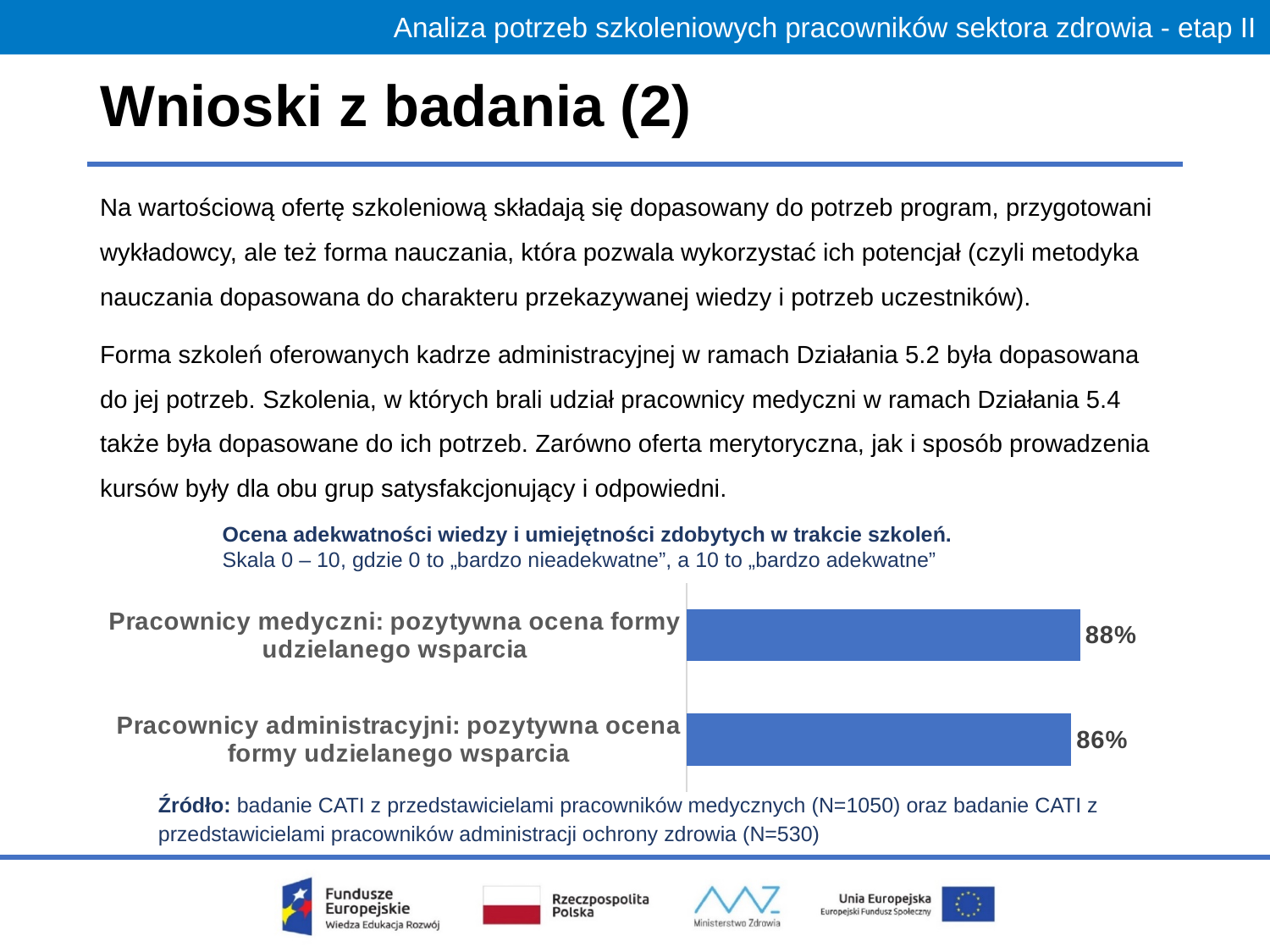
What colour are the bars in the chart? blue What kind of chart is shown on the slide? bar chart Which category has the higher value? Pracownicy medyczni: pozytywna ocena formy udzielanego wsparcia How many categories are shown in the chart? 2 What is the value for "Pracownicy administracyjni: pozytywna ocena formy udzielanego wsparcia"? 86% Which category has the lower value? Pracownicy administracyjni: pozytywna ocena formy udzielanego wsparcia What is the title of the chart? Ocena adekwatności wiedzy i umiejętności zdobytych w trakcie szkoleń. What is the difference between the value for pracownicy medyczni and the value for pracownicy administracyjni? 2% Is the value for pracownicy medyczni larger or smaller than the value for pracownicy administracyjni? larger What is the value for "Pracownicy medyczni: pozytywna ocena formy udzielanego wsparcia"? 88%